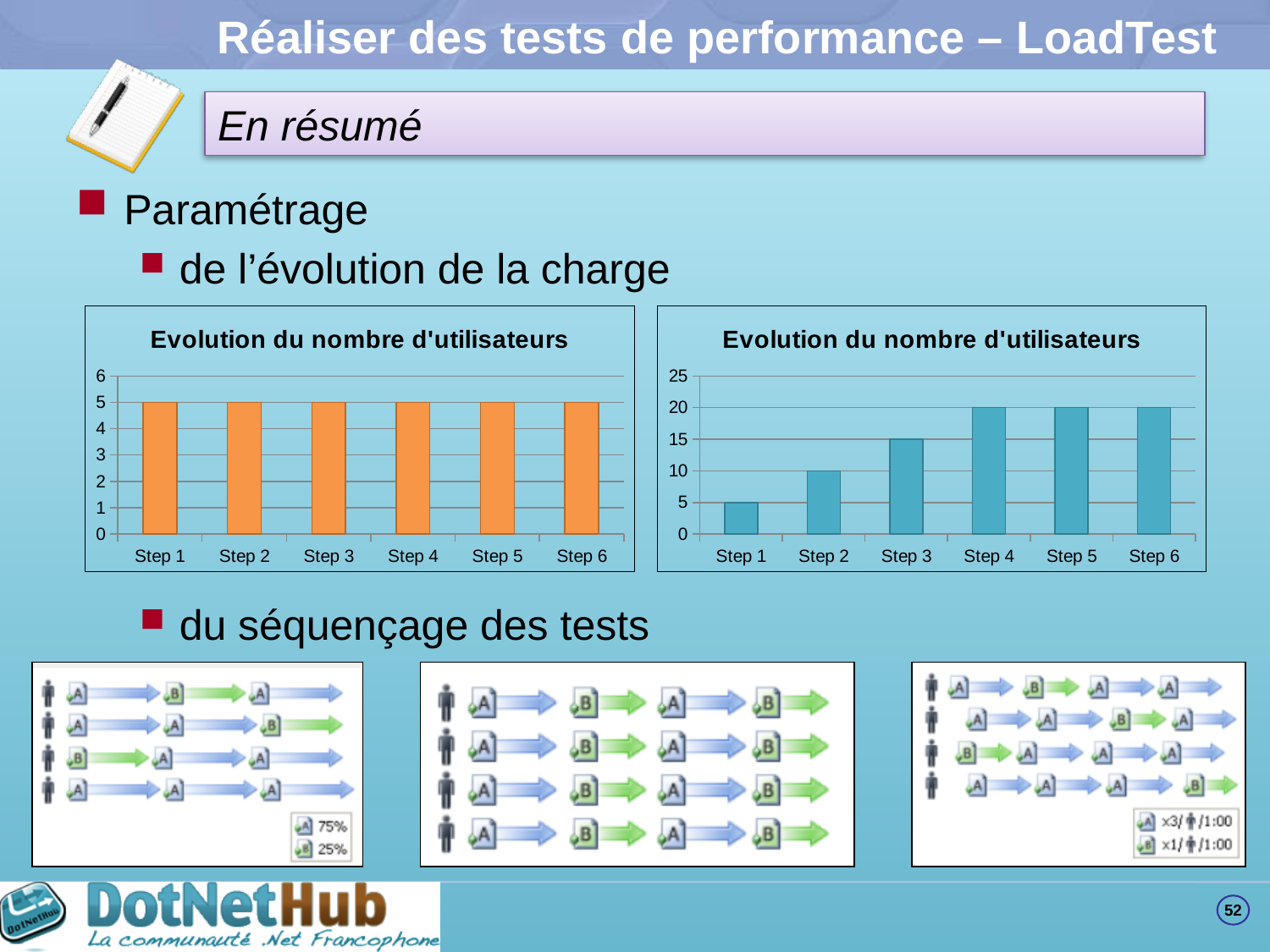
In the right chart, is the value for Step 1 greater or less than 10? less What is the title of the left chart? Evolution du nombre d'utilisateurs In the right chart, which step has the lowest value? Step 1 In the right chart, do the values rise, fall or stay flat from Step 1 to Step 4? rise In the right chart, what is the value for Step 2? 10 In the right chart, which is larger, the value for Step 2 or the value for Step 3? Step 3 How many steps are shown on the x axis of the left chart? 6 In the left chart, do the values rise, fall or stay flat across the steps? stay flat In the left chart, what is the value for Step 3? 5 In the right chart, what is the difference between the values for Step 3 and Step 1? 10 In the right chart, what is the value for Step 4? 20 What kind of chart is the right chart? bar chart